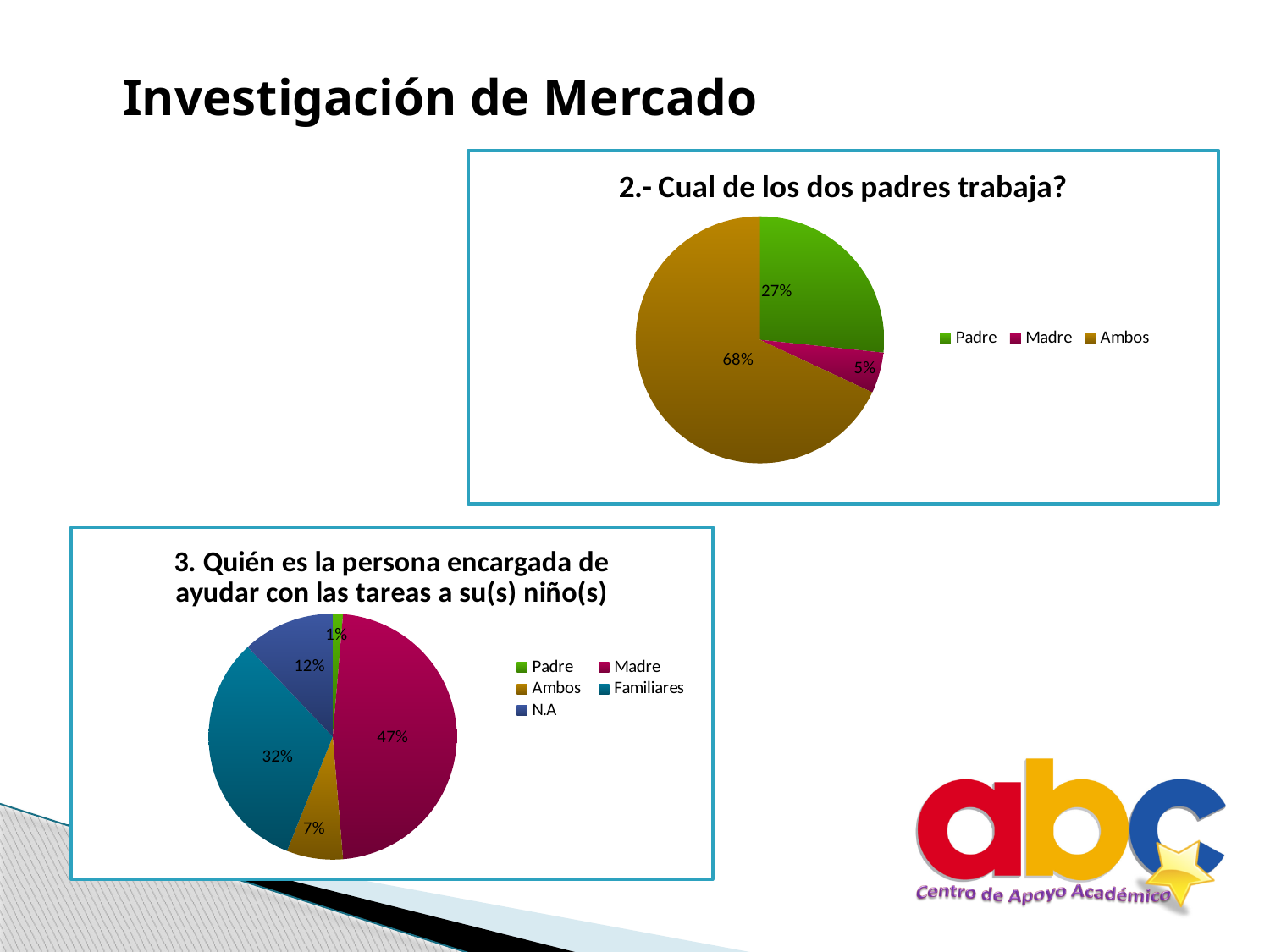
In the chart titled "3. Quién es la persona encargada de ayudar con las tareas a su(s) niño(s)", which category has the smallest slice? Padre What type of chart is the chart titled "2.- Cual de los dos padres trabaja?"? Pie chart In the chart titled "3. Quién es la persona encargada de ayudar con las tareas a su(s) niño(s)", what percentage is shown for Madre? 47% In the chart titled "2.- Cual de los dos padres trabaja?", what percentage is shown for Ambos? 68% In the chart titled "2.- Cual de los dos padres trabaja?", what percentage is shown for Madre? 5% In the chart titled "2.- Cual de los dos padres trabaja?", which category has the largest slice? Ambos In the chart titled "2.- Cual de los dos padres trabaja?", what is the difference in percentage points between Padre and Madre? 22 In the chart titled "3. Quién es la persona encargada de ayudar con las tareas a su(s) niño(s)", what colour is the Familiares slice? Teal In the chart titled "3. Quién es la persona encargada de ayudar con las tareas a su(s) niño(s)", which is larger, N.A or Ambos? N.A In the chart titled "3. Quién es la persona encargada de ayudar con las tareas a su(s) niño(s)", how many categories does the legend list? 5 In the chart titled "2.- Cual de los dos padres trabaja?", how many categories does the legend list? 3 In the chart titled "3. Quién es la persona encargada de ayudar con las tareas a su(s) niño(s)", what percentage is shown for Familiares? 32%